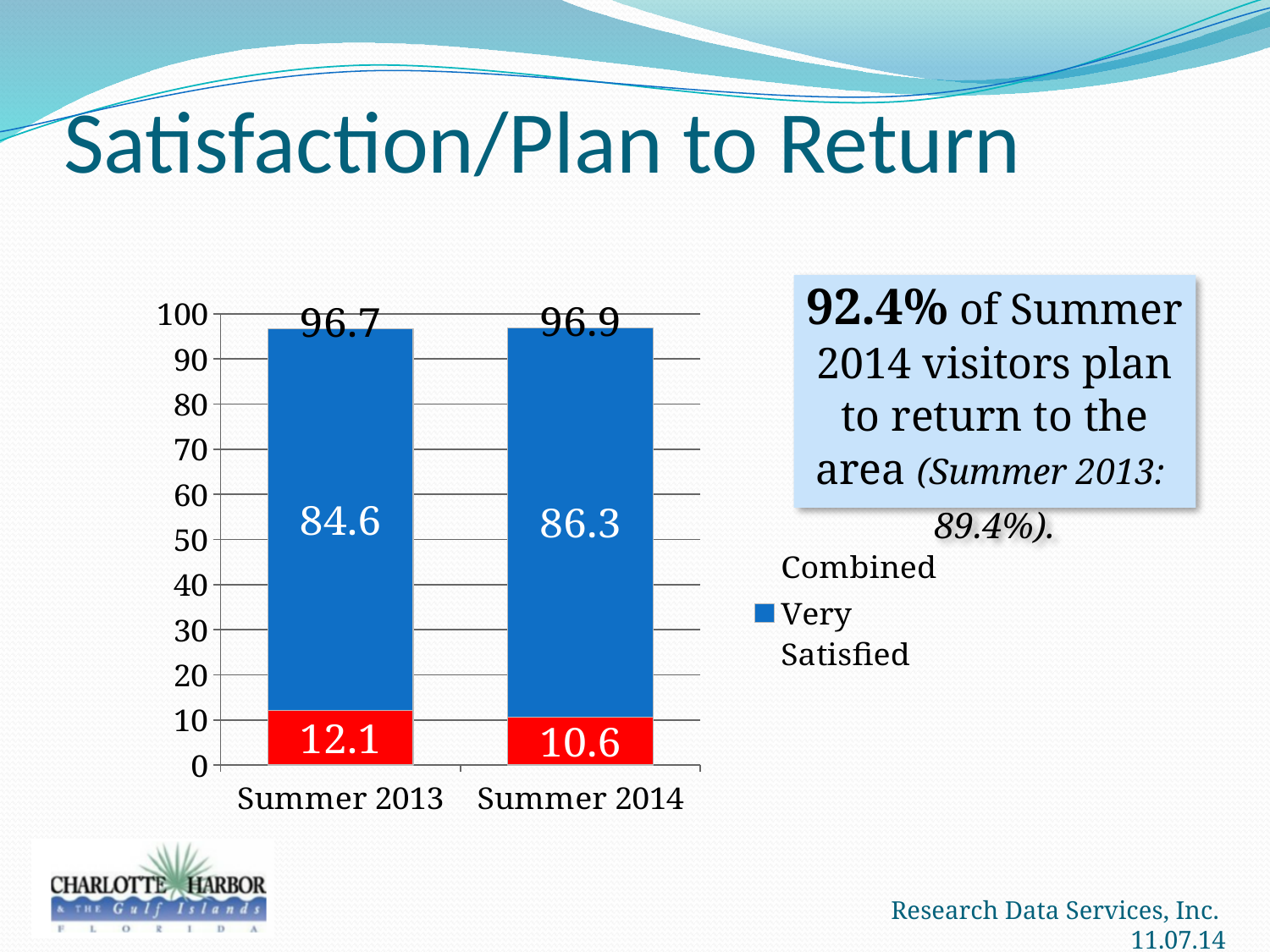
What is the Very Satisfied value for Summer 2014? 86.3 Which category has the higher Very Satisfied value, Summer 2013 or Summer 2014? Summer 2014 What is the total value labeled at the top of the Summer 2013 stacked bar? 96.7 What is the difference between the Very Satisfied values for Summer 2014 and Summer 2013? 1.7 What is the difference between the red segment values for Summer 2013 and Summer 2014? 1.5 What is the total value labeled at the top of the Summer 2014 stacked bar? 96.9 What kind of chart is shown on the slide? Stacked bar chart How many categories are shown on the x axis of the chart? 2 What is the Very Satisfied value for Summer 2013? 84.6 What value is shown for the red segment of the Summer 2013 bar? 12.1 Does the Very Satisfied value rise or fall from Summer 2013 to Summer 2014? Rise What value is shown for the red segment of the Summer 2014 bar? 10.6